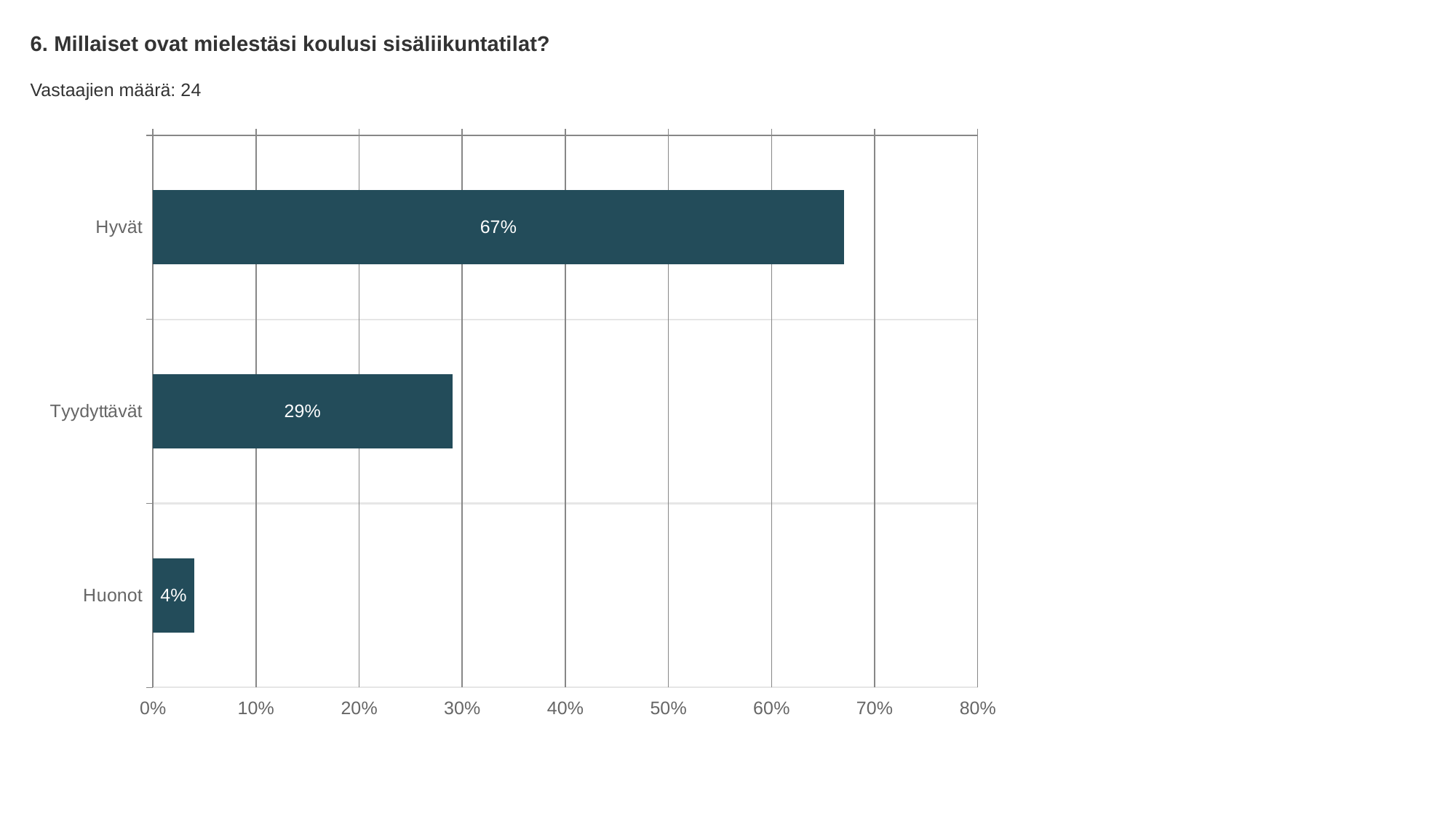
What is the difference in percentage points between "Tyydyttävät" and "Huonot"? 25 How many respondents (Vastaajien määrä) are reported on the slide? 24 What percentage of respondents answered "Huonot"? 4% What kind of chart is shown on the slide? Bar chart Which category has the lowest percentage? Huonot What is the difference in percentage points between "Hyvät" and "Tyydyttävät"? 38 What percentage of respondents answered "Hyvät"? 67% Which category has the highest percentage? Hyvät Which is larger, the value for "Tyydyttävät" or the value for "Huonot"? Tyydyttävät How many categories are shown in the chart? 3 What percentage of respondents answered "Tyydyttävät"? 29% Is the value for "Hyvät" greater or less than 60%? greater